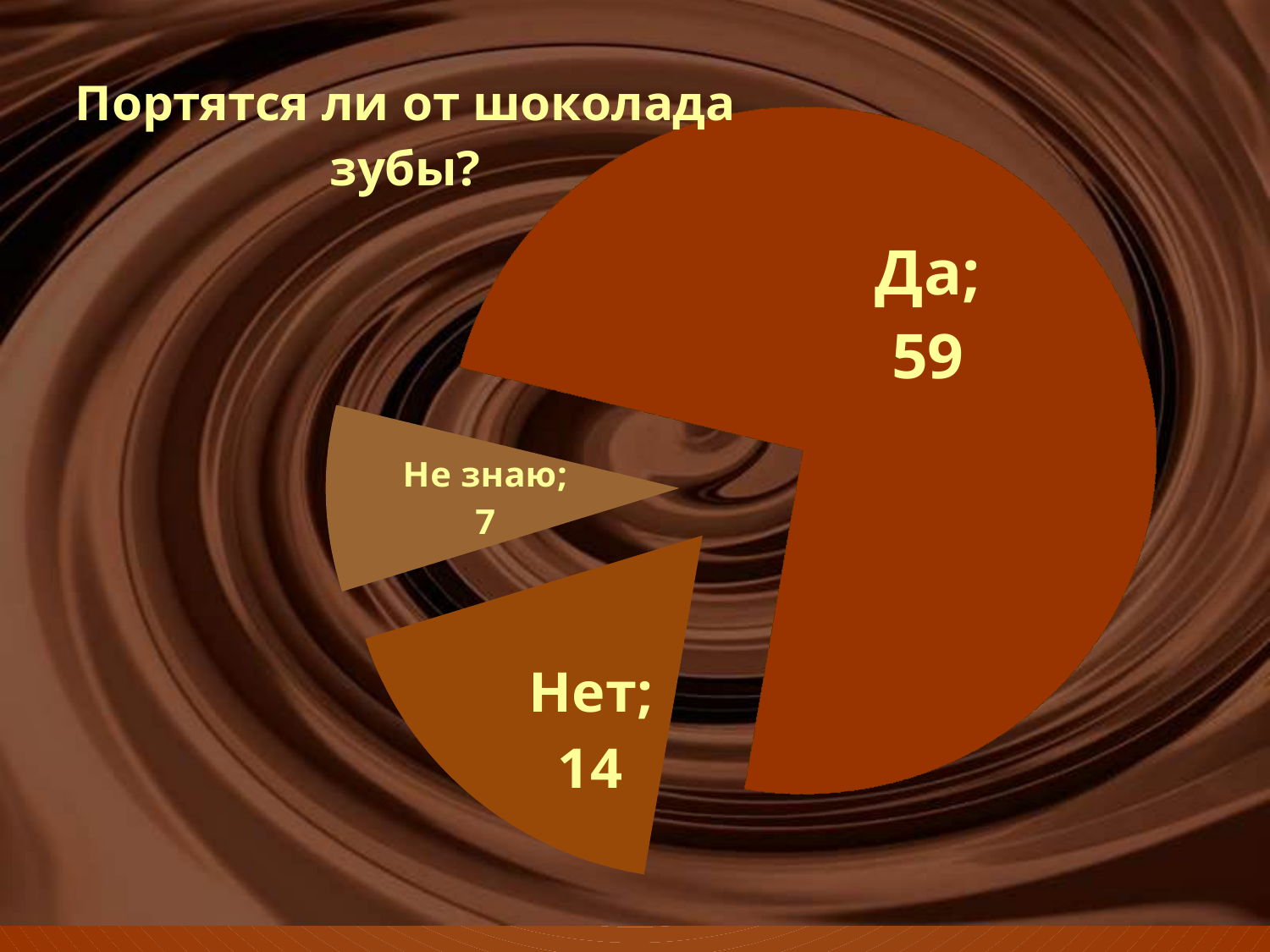
What is the difference between the values for "Нет" and "Не знаю"? 7 What type of chart is shown on the slide? pie chart What is the value for the "Нет" slice? 14 Which is larger, the value for "Нет" or the value for "Не знаю"? Нет What is the value for the "Не знаю" slice? 7 Which slice of the pie chart is the smallest? Не знаю What is the total of all slices in the pie chart? 80 What is the difference between the values for "Да" and "Нет"? 45 How many slices does the pie chart have? 3 What is the title of the chart? Портятся ли от шоколада зубы? Which slice of the pie chart is the largest? Да What is the value for the "Да" slice? 59